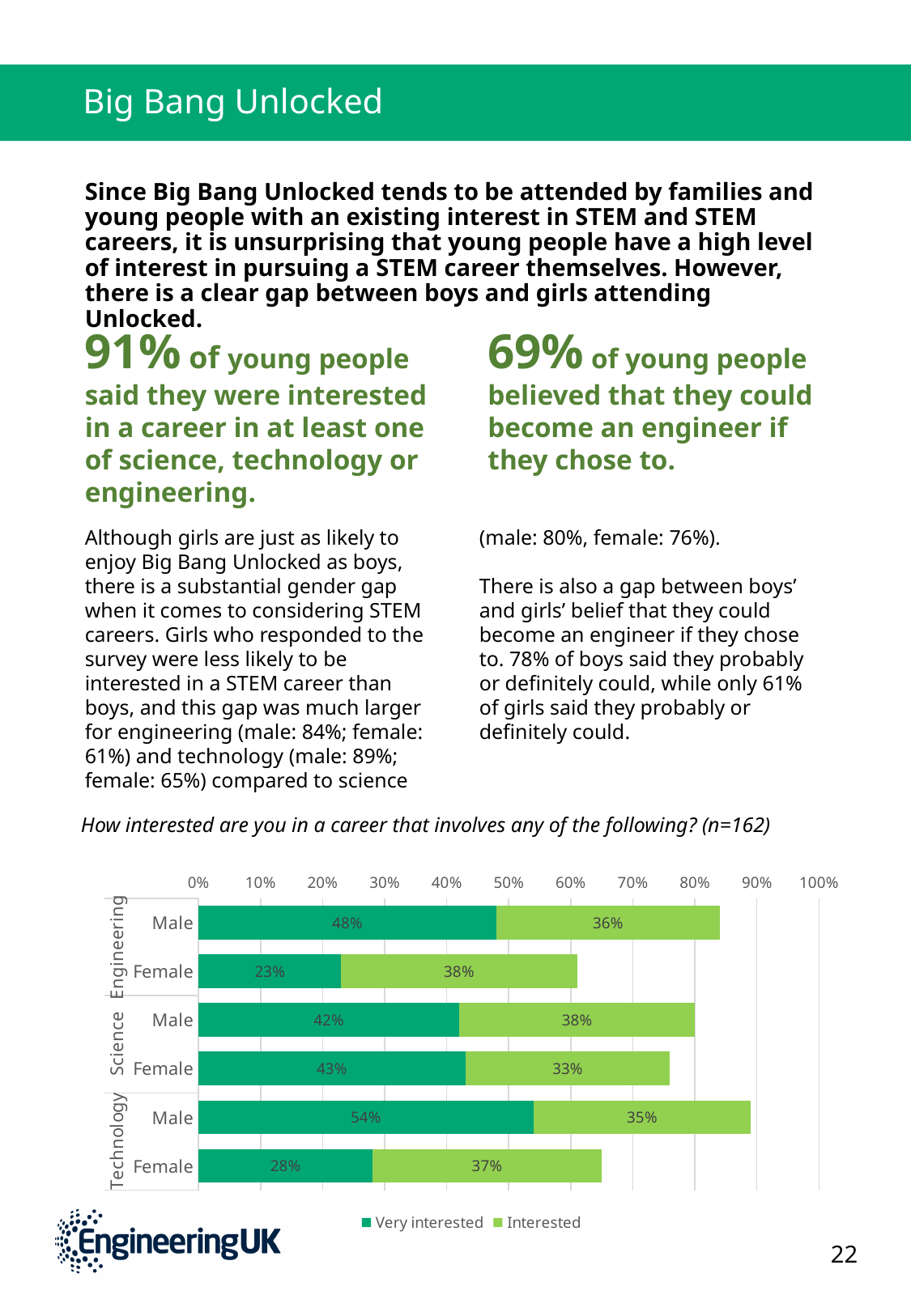
Which category has the highest Very interested value? Technology Male How many series does the legend list? 2 How many bars are shown in the chart? 6 What kind of chart is shown on the slide? Stacked bar chart Which is larger: the Interested value for Engineering Female or for Science Female? Engineering Female What percentage of Science Female respondents were Very interested? 43% What percentage of Technology Female respondents were Interested? 37% What is the difference between the Very interested values for Technology Male and Technology Female? 26% What is the total of the stacked bar for Technology Female? 65% Which category has the lowest Very interested value? Engineering Female What is the total of the stacked bar for Engineering Male? 84% What percentage of Engineering Male respondents were Very interested? 48%